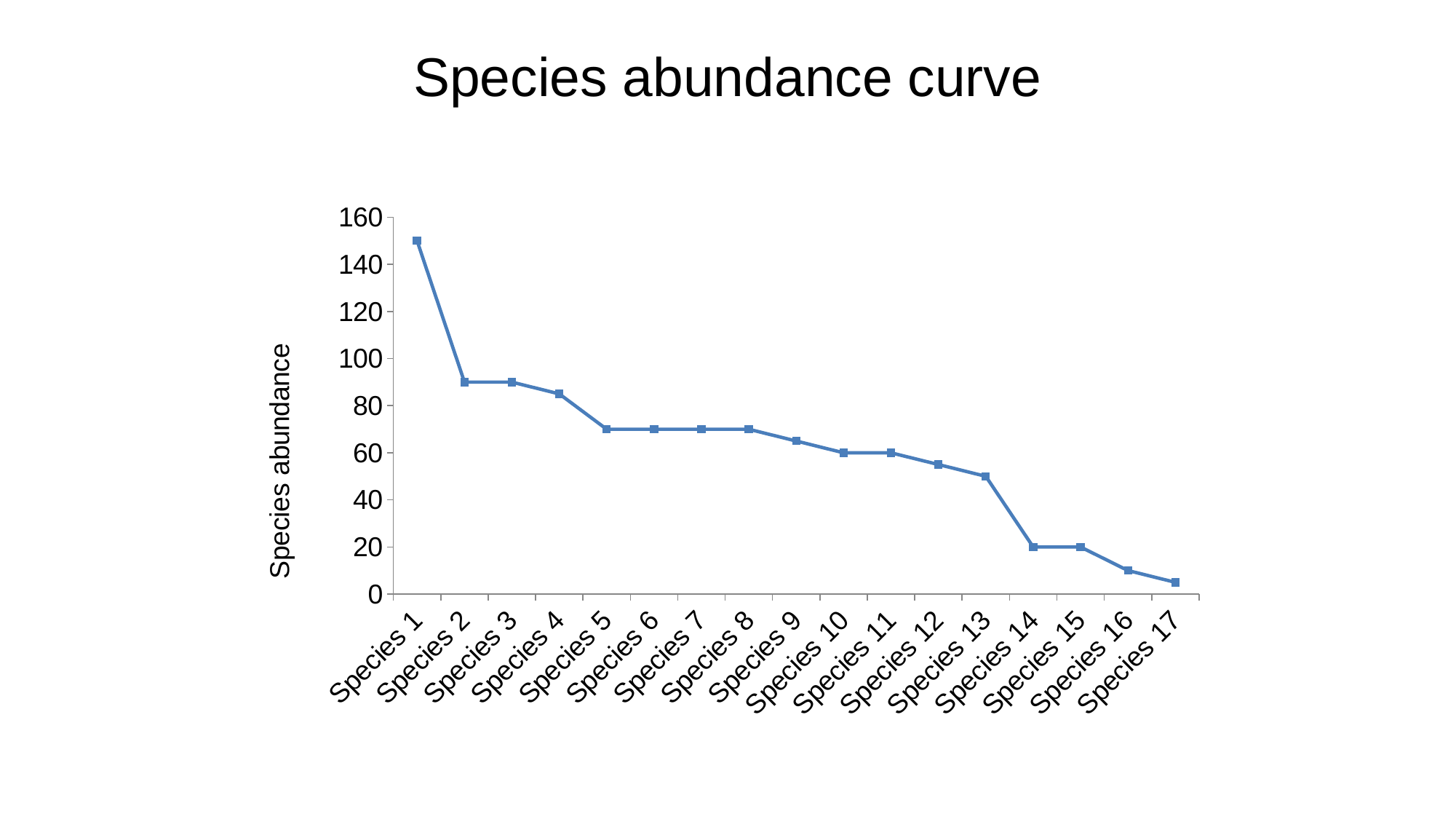
How many species are plotted on the x axis? 17 What is the label of the vertical axis? Species abundance Is the value for Species 13 greater or less than 40? greater Is the value for Species 2 greater or less than 100? less Which has the larger abundance, Species 1 or Species 2? Species 1 Which species has the lowest abundance? Species 17 Which species has the highest abundance? Species 1 Which has the larger abundance, Species 13 or Species 14? Species 13 Do the values rise or fall from Species 1 to Species 17? fall What kind of chart is shown on the slide? line chart Is the value for Species 5 greater or less than 80? less